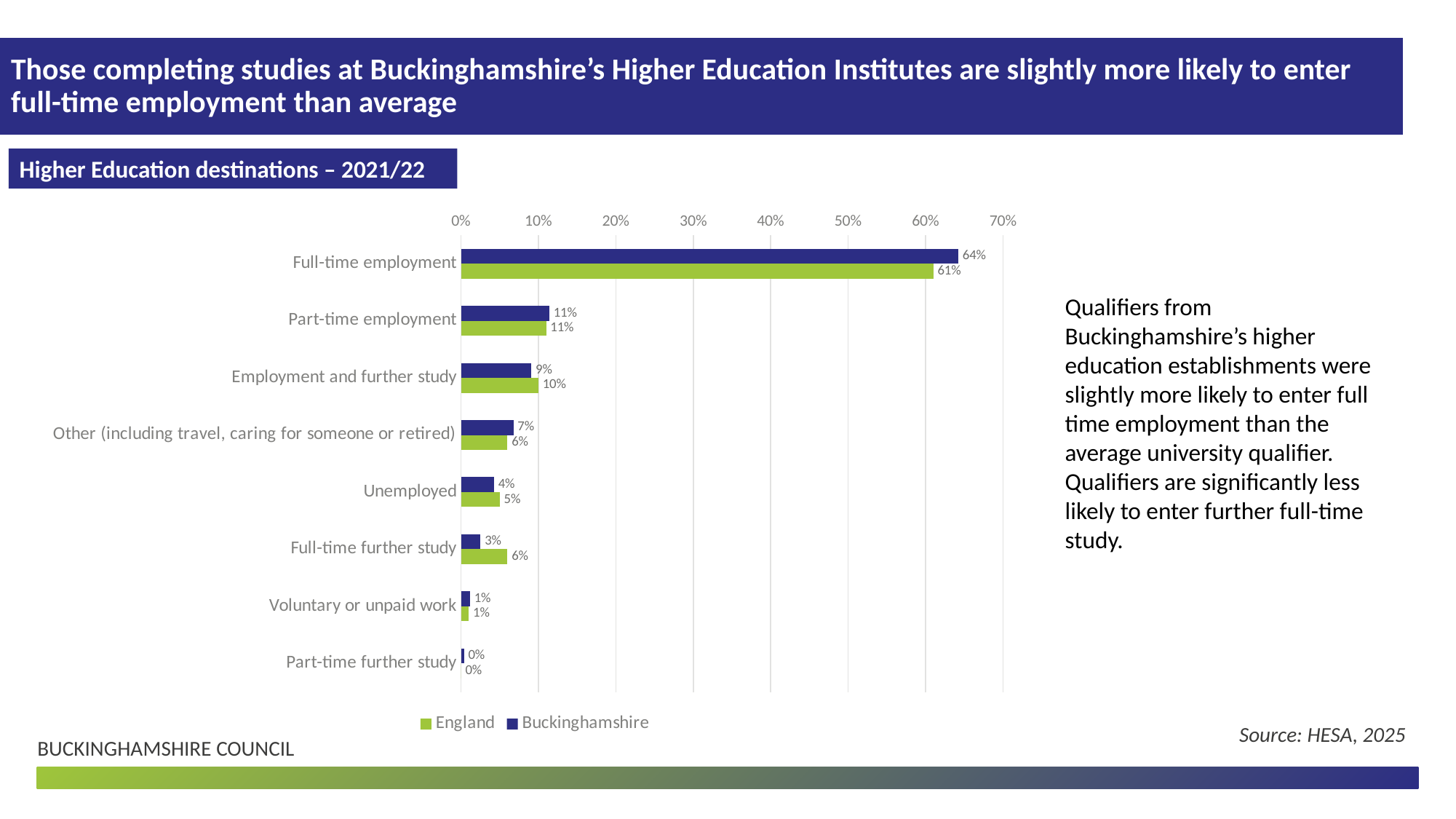
What is the difference between the Buckinghamshire and England values for Full-time employment? 3% How many categories are shown on the chart? 8 Is the Buckinghamshire value for Full-time employment greater or less than 60%? greater What is the England value for Full-time employment? 61% Which category has the lowest England value? Part-time further study How many series does the legend list? 2 Which is larger for Full-time further study, the England value or the Buckinghamshire value? England What kind of chart is shown on the slide? Bar chart What is the Buckinghamshire value for Unemployed? 4% Which category has the highest Buckinghamshire value? Full-time employment What is the Buckinghamshire value for Full-time employment? 64% What is the England value for Full-time further study? 6%